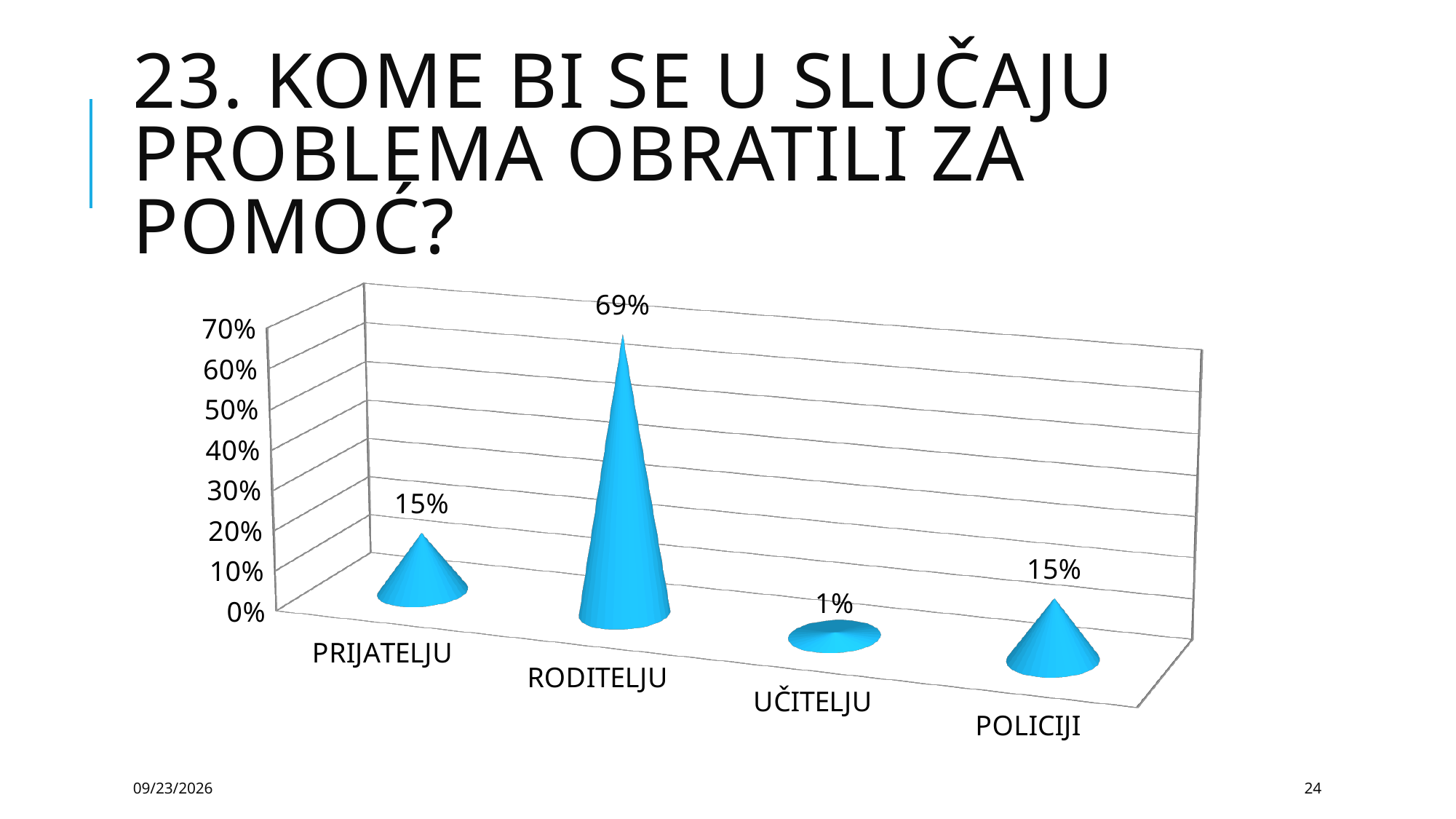
How many categories are shown on the x axis? 4 Which category has the lowest value? UČITELJU What is the value for RODITELJU? 69% What kind of chart is shown on the slide? bar chart What is the value for POLICIJI? 15% Which is larger, the value for RODITELJU or the value for POLICIJI? RODITELJU What is the value for UČITELJU? 1% What is the value for PRIJATELJU? 15% What is the difference between the values for POLICIJI and UČITELJU? 14% What is the difference between the values for RODITELJU and PRIJATELJU? 54% Which category has the highest value? RODITELJU Is the value for RODITELJU greater or less than 50%? greater